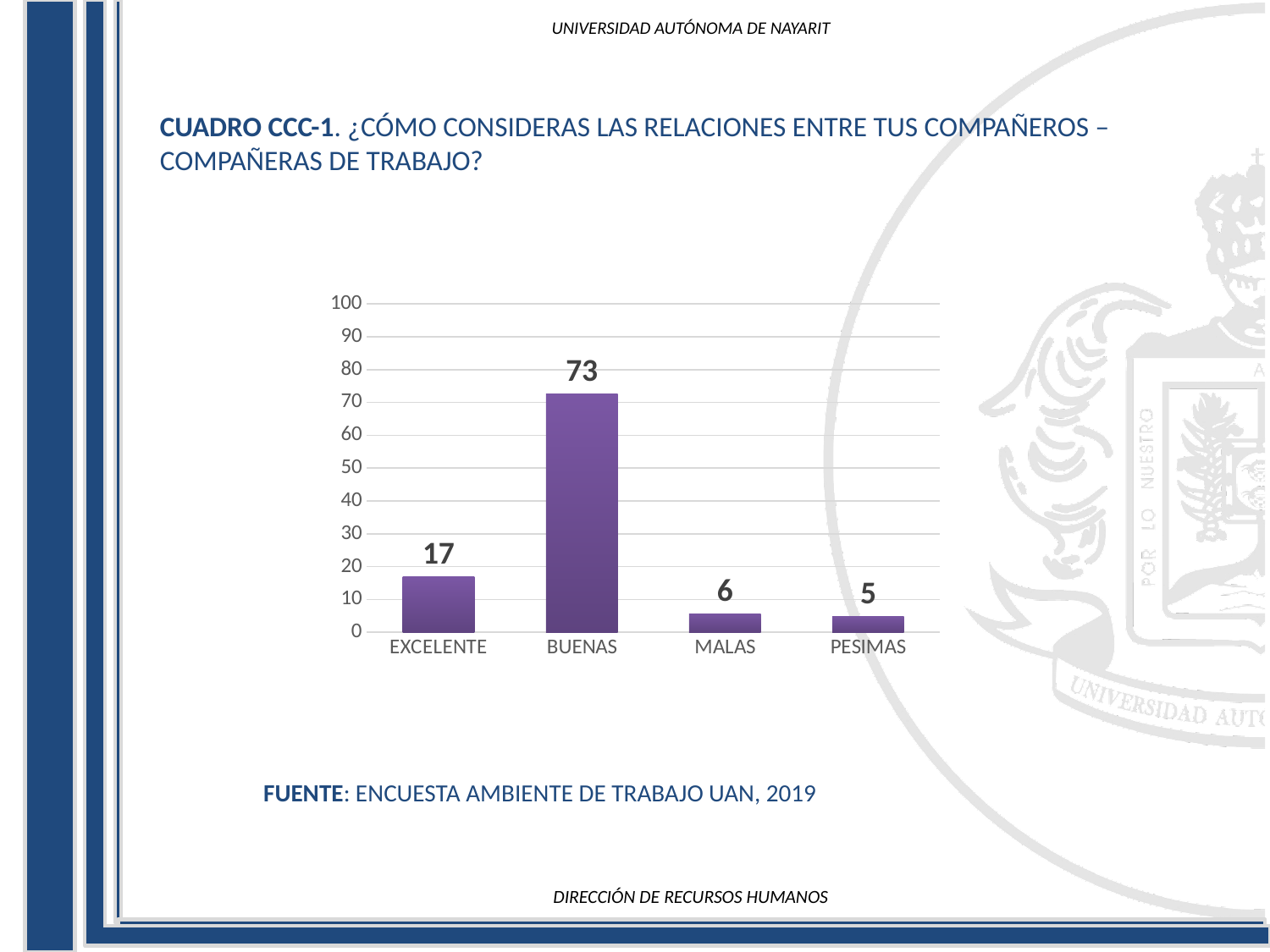
What kind of chart is shown on the slide? bar chart Is the value for BUENAS greater or less than 50? greater What is the source cited below the chart? ENCUESTA AMBIENTE DE TRABAJO UAN, 2019 How many categories are shown on the x axis? 4 What is the value for EXCELENTE? 17 What is the value for BUENAS? 73 Which category has the highest value? BUENAS What is the value for MALAS? 6 Which is larger, the value for EXCELENTE or the value for MALAS? EXCELENTE What is the value for PESIMAS? 5 What is the difference between the values for BUENAS and EXCELENTE? 56 Which category has the lowest value? PESIMAS